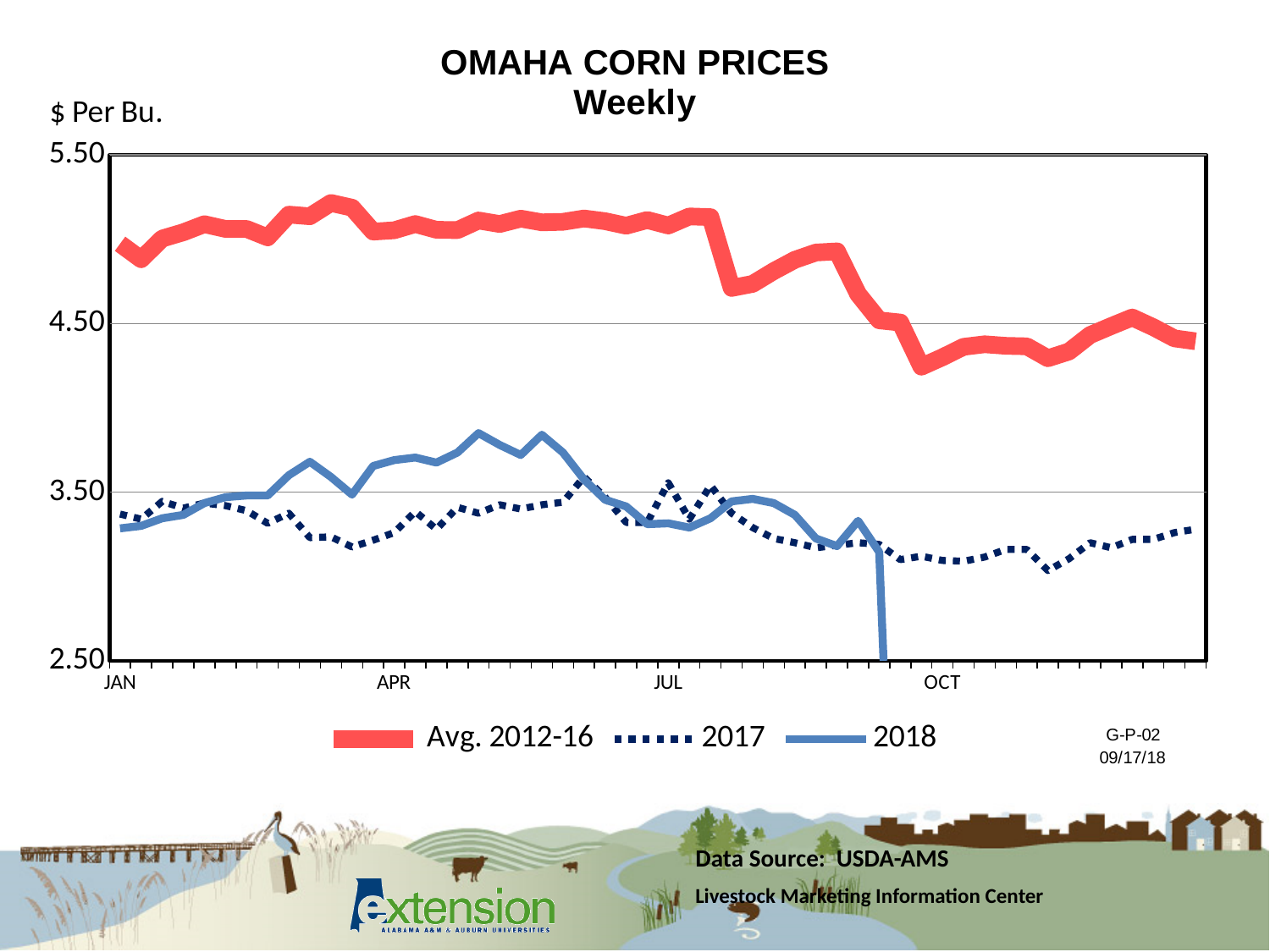
Is the 2017 value in October greater or less than 3.50? less What unit is shown on the y-axis label? $ Per Bu. Which series has the highest prices across the whole year? Avg. 2012-16 Which series has the lowest value shown on the chart, dropping toward the bottom of the axis near October? 2018 Which is larger in May, the 2018 value or the 2017 value? 2018 Is the 2018 value in April greater or less than 3.50? greater What is the title of the chart? OMAHA CORN PRICES Weekly Is the Avg. 2012-16 value in October greater or less than 4.50? less Does the Avg. 2012-16 line rise or fall between July and October? fall How many series does the legend list? 3 What kind of chart is shown on the slide? line chart